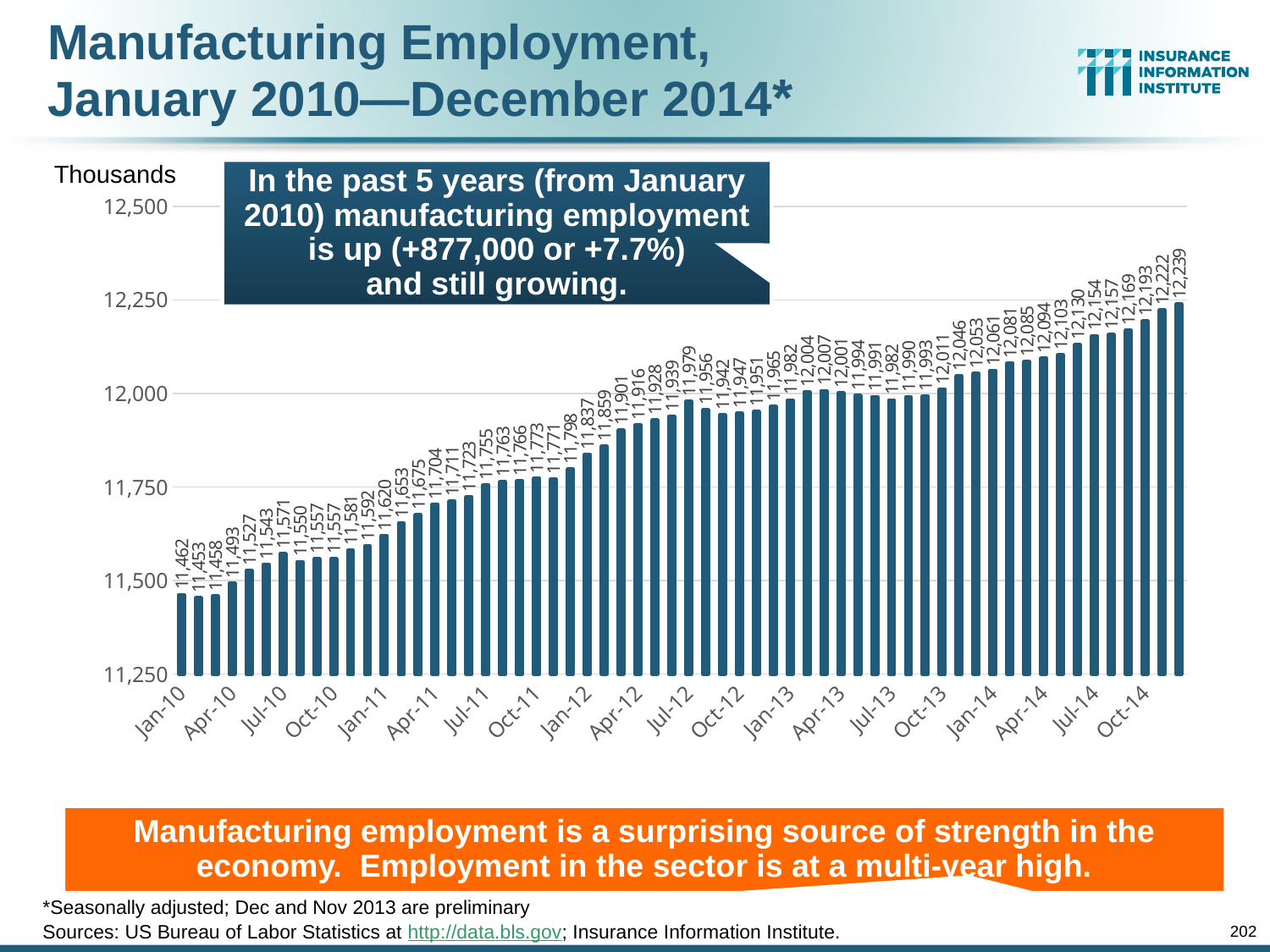
What is the manufacturing employment value for Jan-13? 11,982 What is the manufacturing employment value for Jan-10? 11,462 Which month has the highest manufacturing employment value? Dec-14 What unit label is shown above the vertical axis? Thousands Is the value for Oct-14 greater or less than 12,000? greater What is the lowest value shown on the chart? 11,453 Which is larger, the value for Jan-12 or the value for Jan-11? Jan-12 What is the manufacturing employment value for Jan-14? 12,061 What is the manufacturing employment value for the last bar, Dec-14? 12,239 Do the values generally rise or fall from Jan-10 to Dec-14? Rise What type of chart is shown on the slide? Bar chart What is the difference between the Dec-14 value (12,239) and the Jan-14 value (12,061)? 178